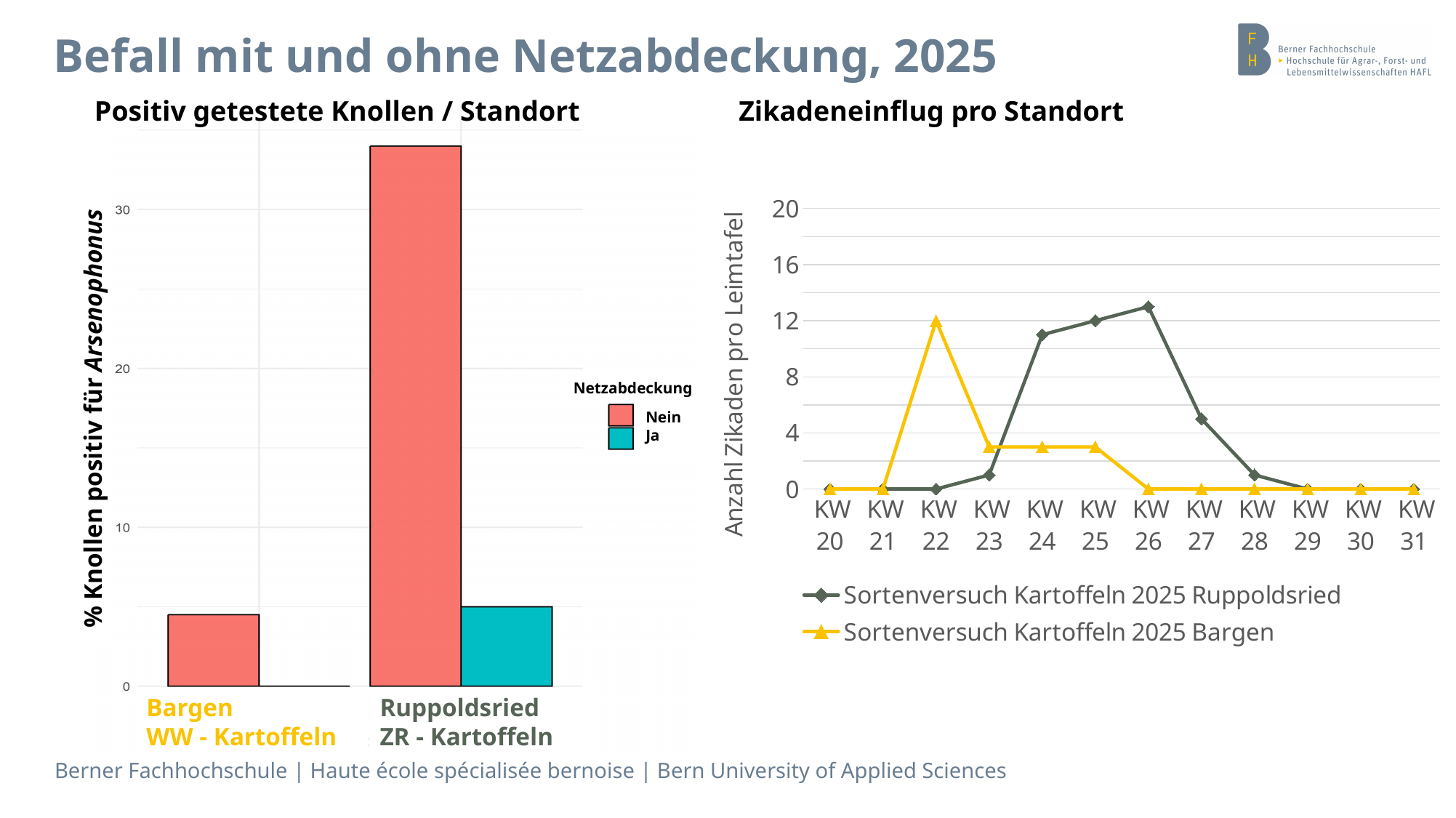
In the chart 'Positiv getestete Knollen / Standort', what kind of chart is shown? bar chart In the chart 'Positiv getestete Knollen / Standort', is the value for Bargen WW - Kartoffeln with Netzabdeckung 'Nein' greater or less than 10? less In the chart 'Zikadeneinflug pro Standort', what is the value for Sortenversuch Kartoffeln 2025 Bargen in KW 22? 12 In the chart 'Positiv getestete Knollen / Standort', which location has the higher value for Netzabdeckung 'Nein', Bargen or Ruppoldsried? Ruppoldsried In the chart 'Zikadeneinflug pro Standort', in which calendar week does Sortenversuch Kartoffeln 2025 Ruppoldsried reach its highest value? KW 26 In the chart 'Positiv getestete Knollen / Standort', is the value for Ruppoldsried ZR - Kartoffeln with Netzabdeckung 'Nein' greater or less than 30? greater In the chart 'Zikadeneinflug pro Standort', what kind of chart is shown? line chart In the chart 'Zikadeneinflug pro Standort', how many calendar weeks (KW) are shown on the x axis? 12 In the chart 'Zikadeneinflug pro Standort', is the value for Sortenversuch Kartoffeln 2025 Ruppoldsried in KW 24 greater or less than 8? greater In the chart 'Positiv getestete Knollen / Standort', how many entries does the Netzabdeckung legend list? 2 In the chart 'Zikadeneinflug pro Standort', which series has the higher value in KW 25, Ruppoldsried or Bargen? Ruppoldsried In the chart 'Positiv getestete Knollen / Standort', which colour represents Netzabdeckung 'Ja'? teal